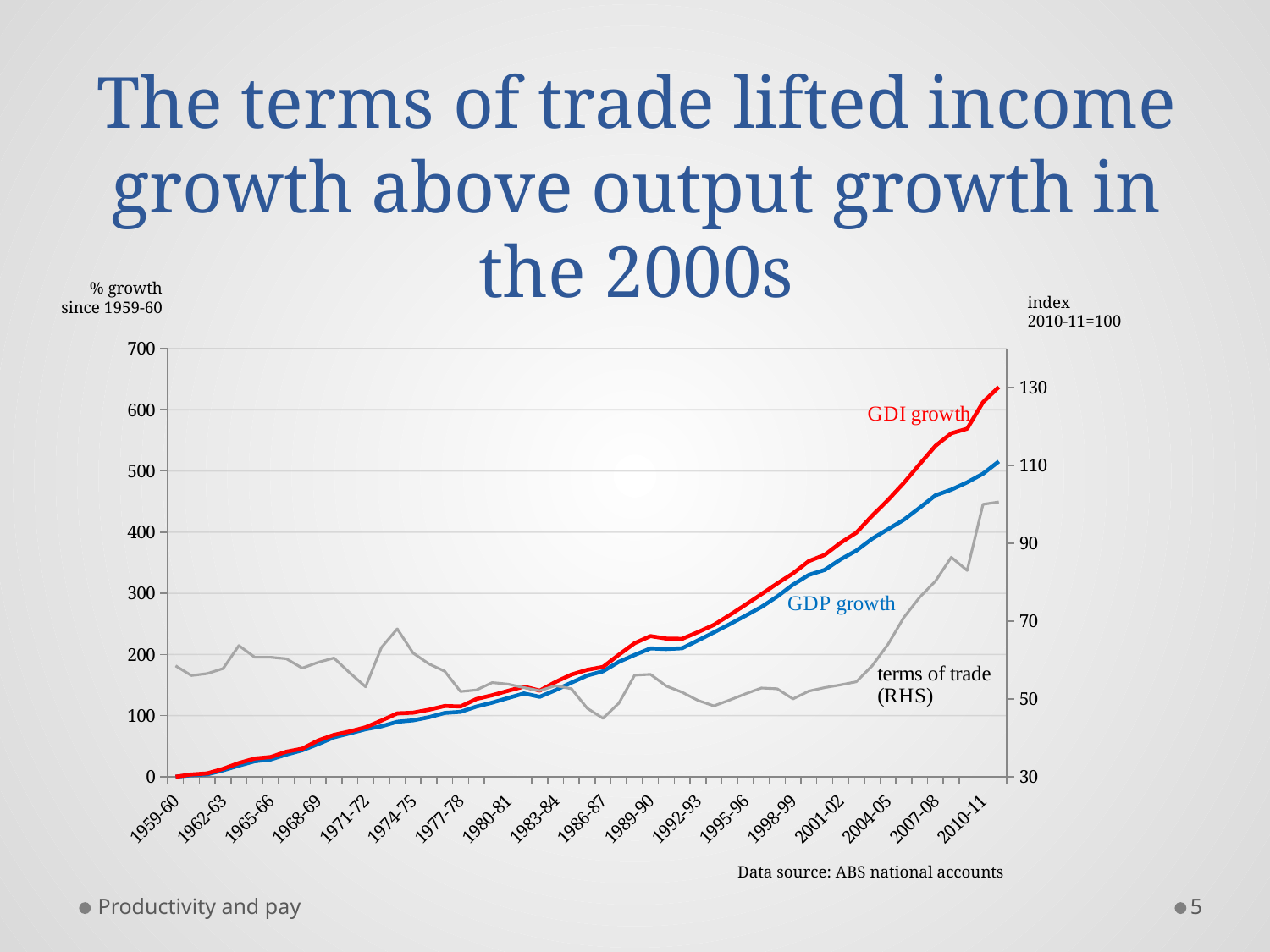
Is the value for terms of trade in 1986-87 greater or less than 50? less How many data series are plotted on the chart? 3 What is the value of GDI growth in 1959-60? 0 Is the value for terms of trade in 2010-11 greater or less than 90? greater Is the value for GDP growth in 2010-11 greater or less than 600? less What kind of chart is shown on the slide? line chart Which series is plotted against the right-hand axis? terms of trade In 2010-11, which is larger: GDI growth or GDP growth? GDI growth Does GDP growth rise or fall from 1959-60 to 2010-11? rise What is the data source given below the chart? ABS national accounts Which is larger for terms of trade: the value in 1974-75 or the value in 1986-87? 1974-75